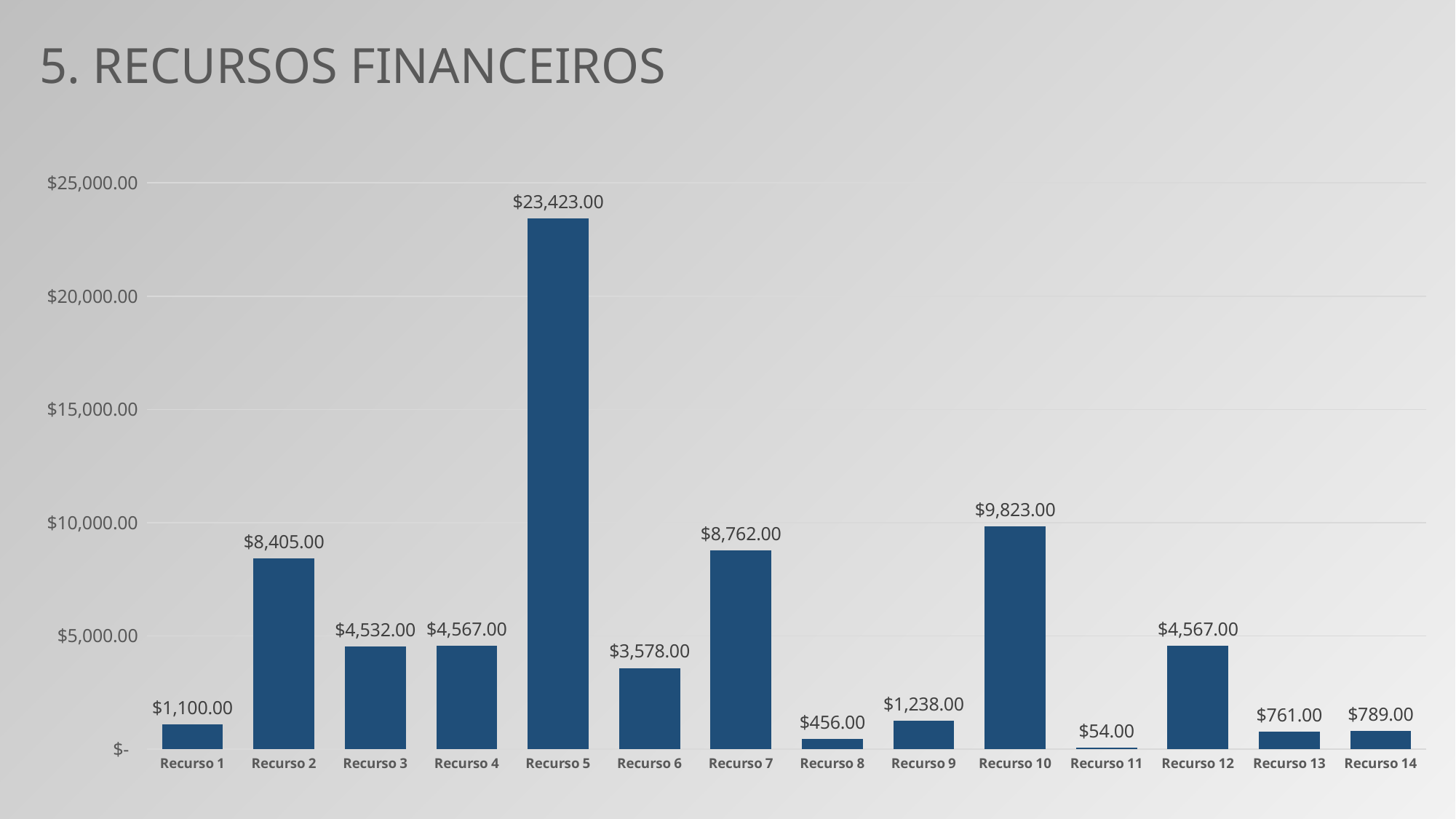
Is the value for Recurso 10 greater or less than $5,000.00? greater What is the value for Recurso 5? $23,423.00 What kind of chart is shown on the slide? bar chart Which is larger, the value for Recurso 13 or the value for Recurso 14? Recurso 14 What is the value for Recurso 11? $54.00 How many categories are shown on the x axis? 14 What is the title of the slide? 5. RECURSOS FINANCEIROS Which category has the lowest value? Recurso 11 Which category has the highest value? Recurso 5 What is the difference between the values for Recurso 5 and Recurso 10? $13,600.00 What is the value for Recurso 10? $9,823.00 What is the difference between the values for Recurso 2 and Recurso 7? $357.00